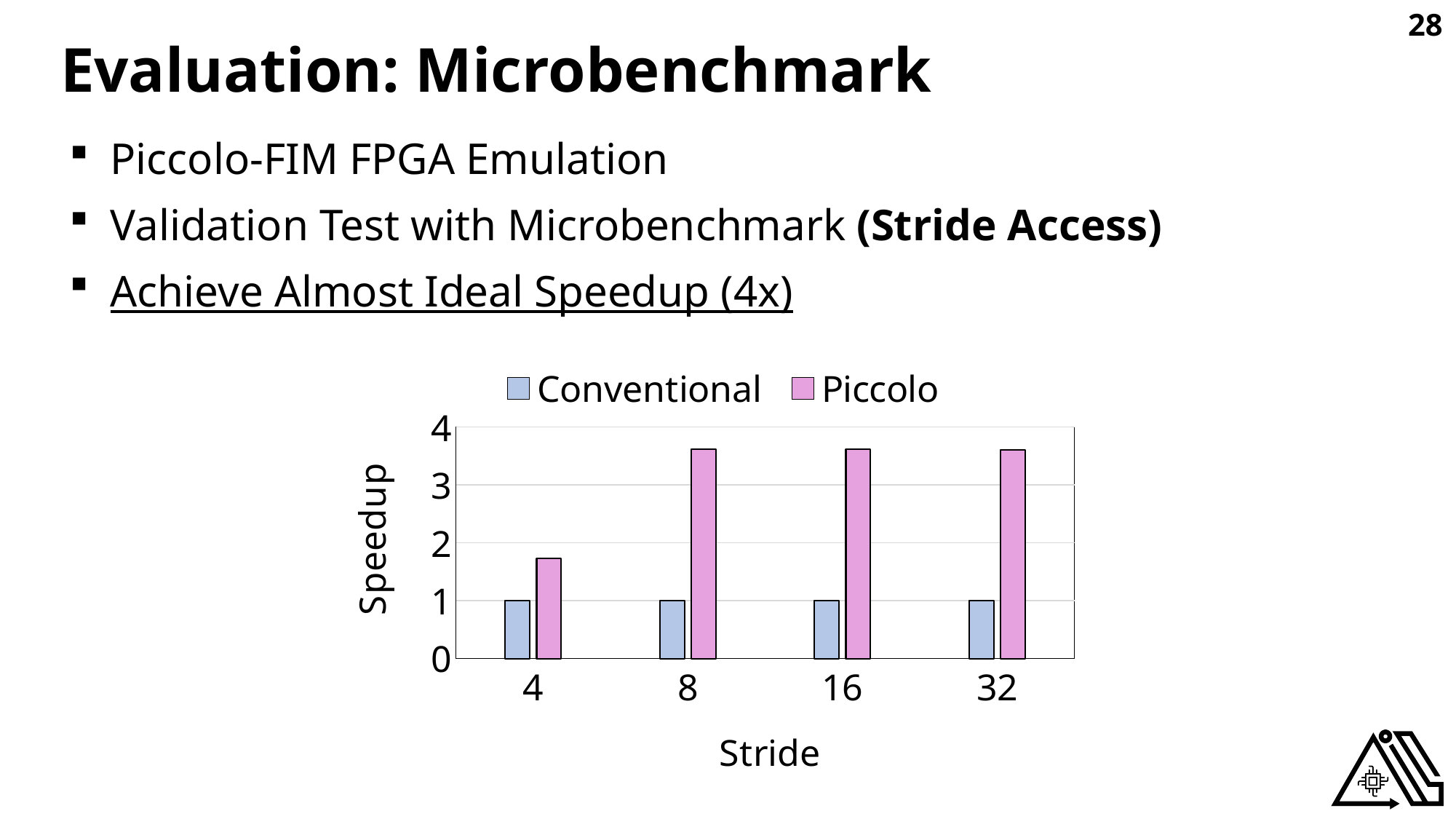
What is the label of the y axis of the chart? Speedup Is the Piccolo speedup at stride 8 greater or less than 3? greater What is the Conventional speedup at stride 4? 1 At stride 8, which series has the higher speedup, Conventional or Piccolo? Piccolo What kind of chart is shown on the slide? bar chart How many stride values are shown on the x axis of the chart? 4 What is the Conventional speedup at stride 32? 1 Is the Piccolo speedup at stride 4 greater or less than 2? less How many series does the chart's legend list? 2 What is the label of the x axis of the chart? Stride At which stride is the Piccolo speedup lowest? 4 Is the Piccolo speedup at stride 16 greater or less than 4? less